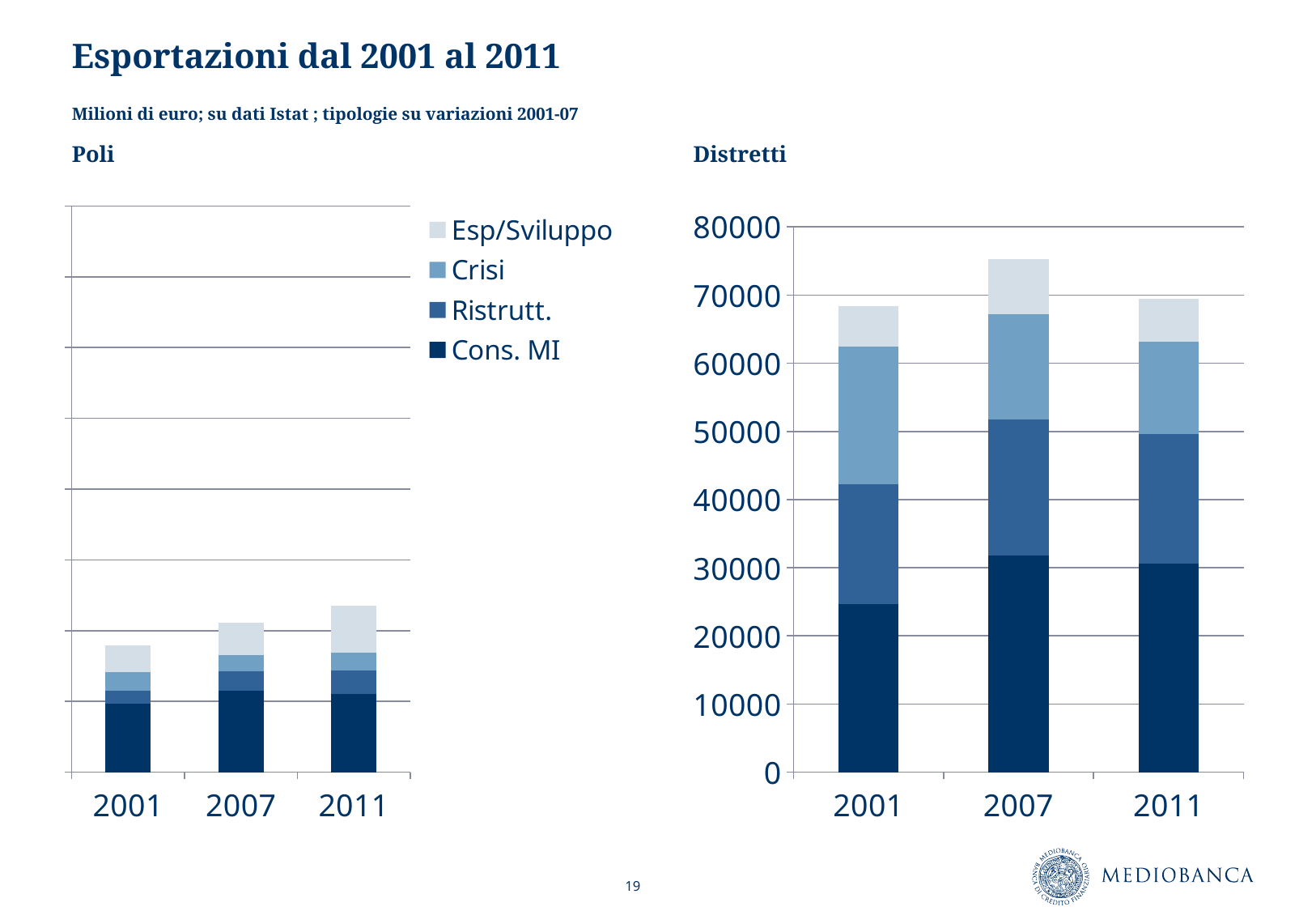
In the Poli chart, which year has the tallest stacked bar? 2011 How many series does the legend on the Poli chart list? 4 In the Distretti chart, is the Cons. MI segment for 2007 greater or less than 30000? greater In the Distretti chart, is the Cons. MI segment for 2001 greater or less than 30000? less What kind of chart is the Distretti chart? stacked bar chart In the Distretti chart, which is larger, the total for 2007 or the total for 2001? 2007 In the Poli chart, which year has the shortest stacked bar? 2001 Which legend entry on the Poli chart is shown in the darkest blue? Cons. MI In the Distretti chart, is the total of the 2001 bar greater or less than 70000? less How many years are shown on the x axis of the Distretti chart? 3 In the Distretti chart, which year has the tallest stacked bar? 2007